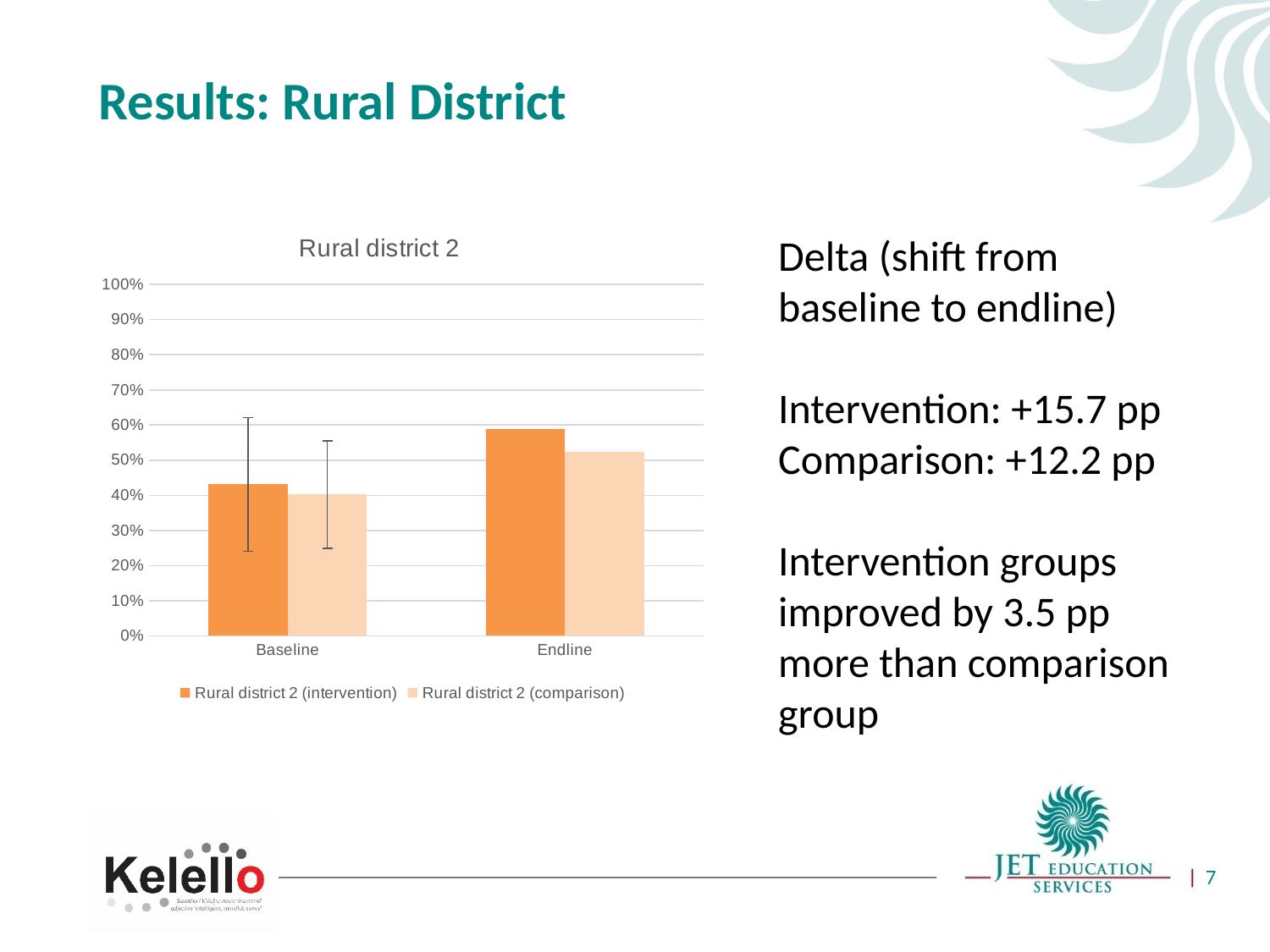
Is the Endline value for Rural district 2 (intervention) greater or less than 50%? greater Is the Baseline value for Rural district 2 (intervention) greater or less than 50%? less How many series does the chart's legend list? 2 What kind of chart is shown on the slide? bar chart Is the Baseline value for Rural district 2 (comparison) greater or less than 50%? less At Endline, which series has the larger value: Rural district 2 (intervention) or Rural district 2 (comparison)? Rural district 2 (intervention) How many categories are shown on the x axis of the chart? 2 Which series is shown in the darker orange colour? Rural district 2 (intervention) What is the title of the chart? Rural district 2 Which bar in the chart is the highest? Rural district 2 (intervention) at Endline Do the values for Rural district 2 (intervention) rise or fall from Baseline to Endline? rise